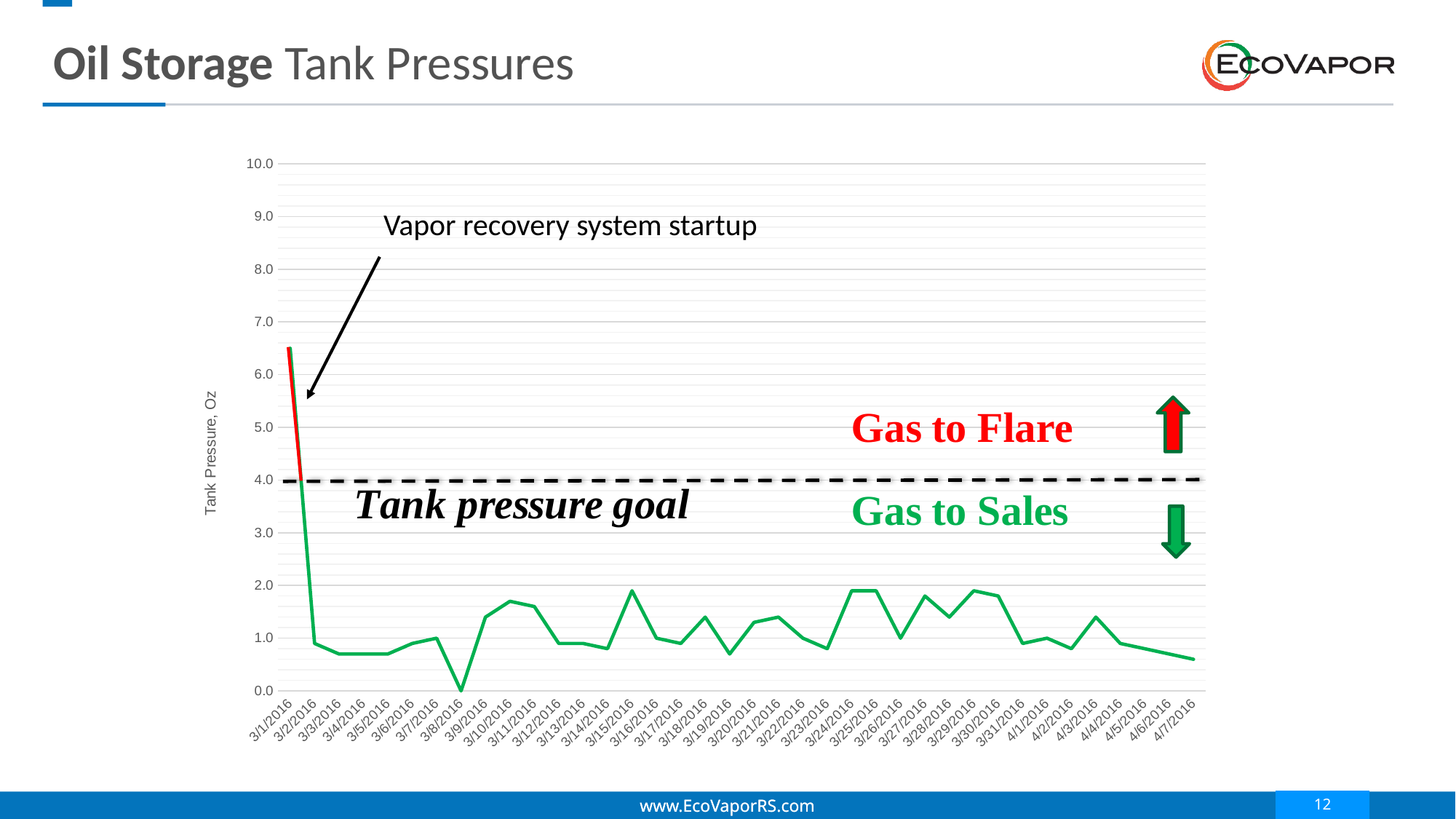
What is the label on the y axis of the chart? Tank Pressure, Oz What is the tank pressure on 3/8/2016? 0.0 What kind of chart is shown on the slide? line chart Which date has the higher tank pressure, 3/10/2016 or 3/19/2016? 3/10/2016 Is the tank pressure on 3/1/2016 greater or less than 6.0? greater Is the tank pressure on 3/25/2016 greater or less than 3.0? less On which date is the tank pressure highest? 3/1/2016 Is the tank pressure on 3/2/2016 greater or less than 2.0? less How many dates are plotted along the x axis of the chart? 38 Does the tank pressure rise or fall from 3/1/2016 to 3/2/2016? fall Which date has the higher tank pressure, 3/1/2016 or 3/2/2016? 3/1/2016 On which date is the tank pressure lowest? 3/8/2016